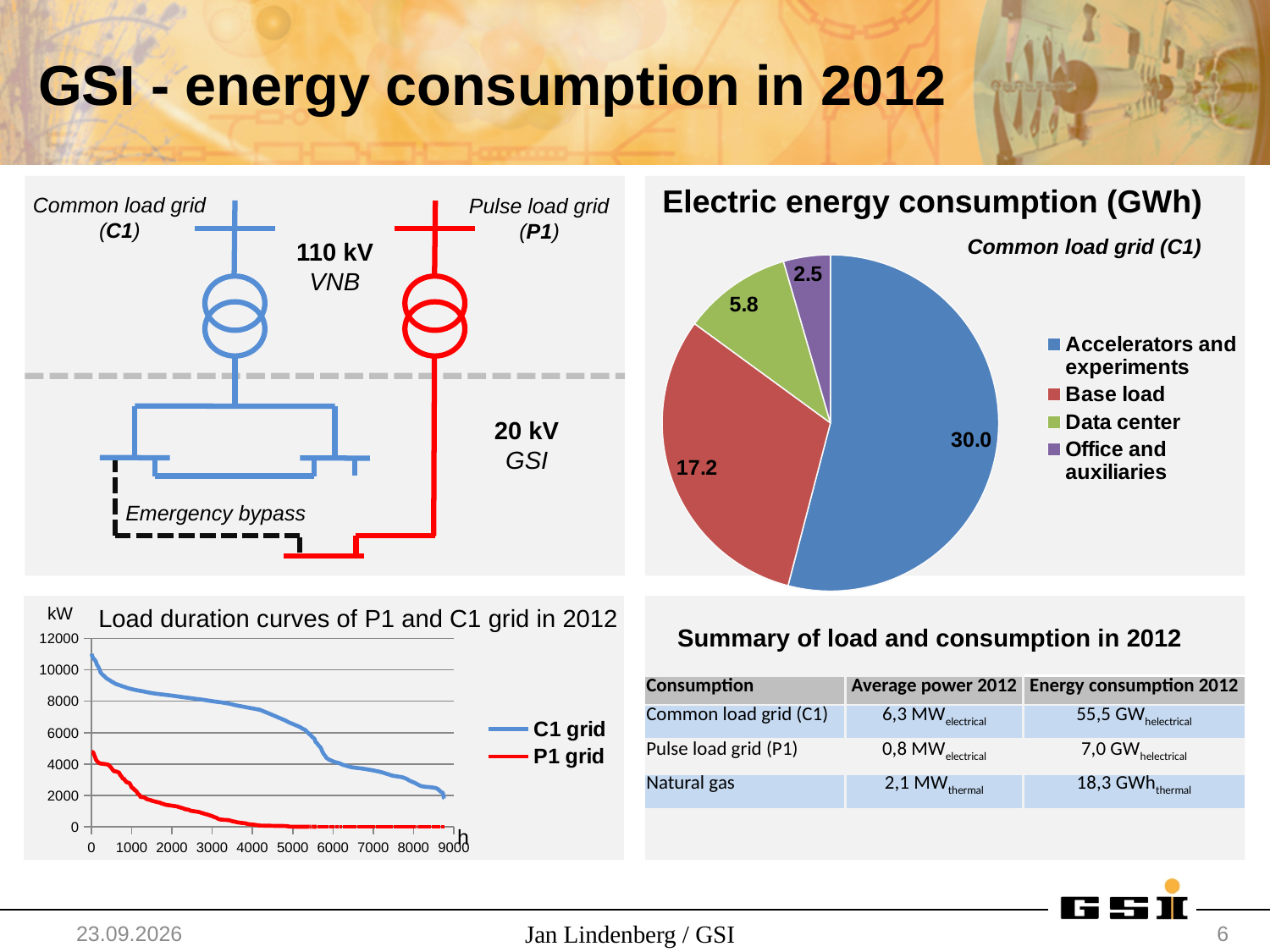
In the Electric energy consumption (GWh) pie chart, which category has the smallest slice? Office and auxiliaries In the Electric energy consumption (GWh) pie chart, which is larger: Data center or Office and auxiliaries? Data center In the Electric energy consumption (GWh) pie chart, what is the value for Base load? 17.2 What type of chart is the Electric energy consumption (GWh) chart? Pie chart In the Load duration curves of P1 and C1 grid in 2012 chart, how many series does the legend list? 2 In the Electric energy consumption (GWh) pie chart, what is the difference between Accelerators and experiments and Base load? 12.8 In the Electric energy consumption (GWh) pie chart, what is the value for Data center? 5.8 In the Load duration curves of P1 and C1 grid in 2012 chart, is the value of the C1 grid at 0 h greater or less than 10000? greater In the Electric energy consumption (GWh) pie chart, which category has the largest slice? Accelerators and experiments In the Electric energy consumption (GWh) pie chart, how many categories are shown? 4 In the Load duration curves of P1 and C1 grid in 2012 chart, do the curves rise or fall along the x axis? fall In the Electric energy consumption (GWh) pie chart, what is the value for Office and auxiliaries? 2.5